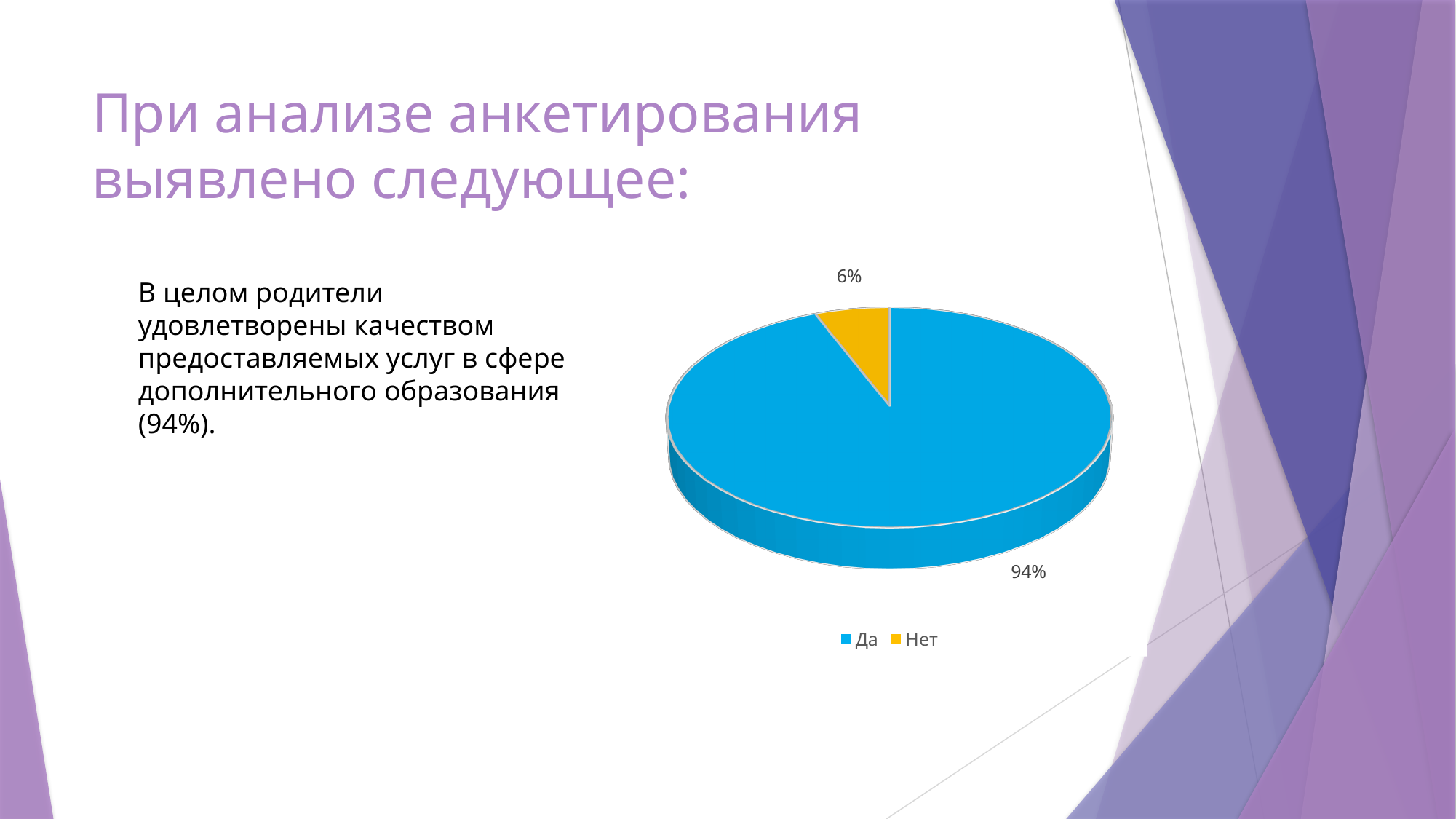
What colour is the Да slice in the pie chart? blue Which category has the smallest slice in the pie chart? Нет What colour is the Нет slice in the pie chart? yellow What is the value for Да in the pie chart? 94% Which is larger, the slice for Да or the slice for Нет? Да How many entries does the legend list? 2 What is the difference between the values for Да and Нет? 88% What share of the pie does the Да slice represent? 94% How many slices does the pie chart have? 2 What kind of chart is shown on the slide? pie chart Which category has the largest slice in the pie chart? Да What is the value for Нет in the pie chart? 6%